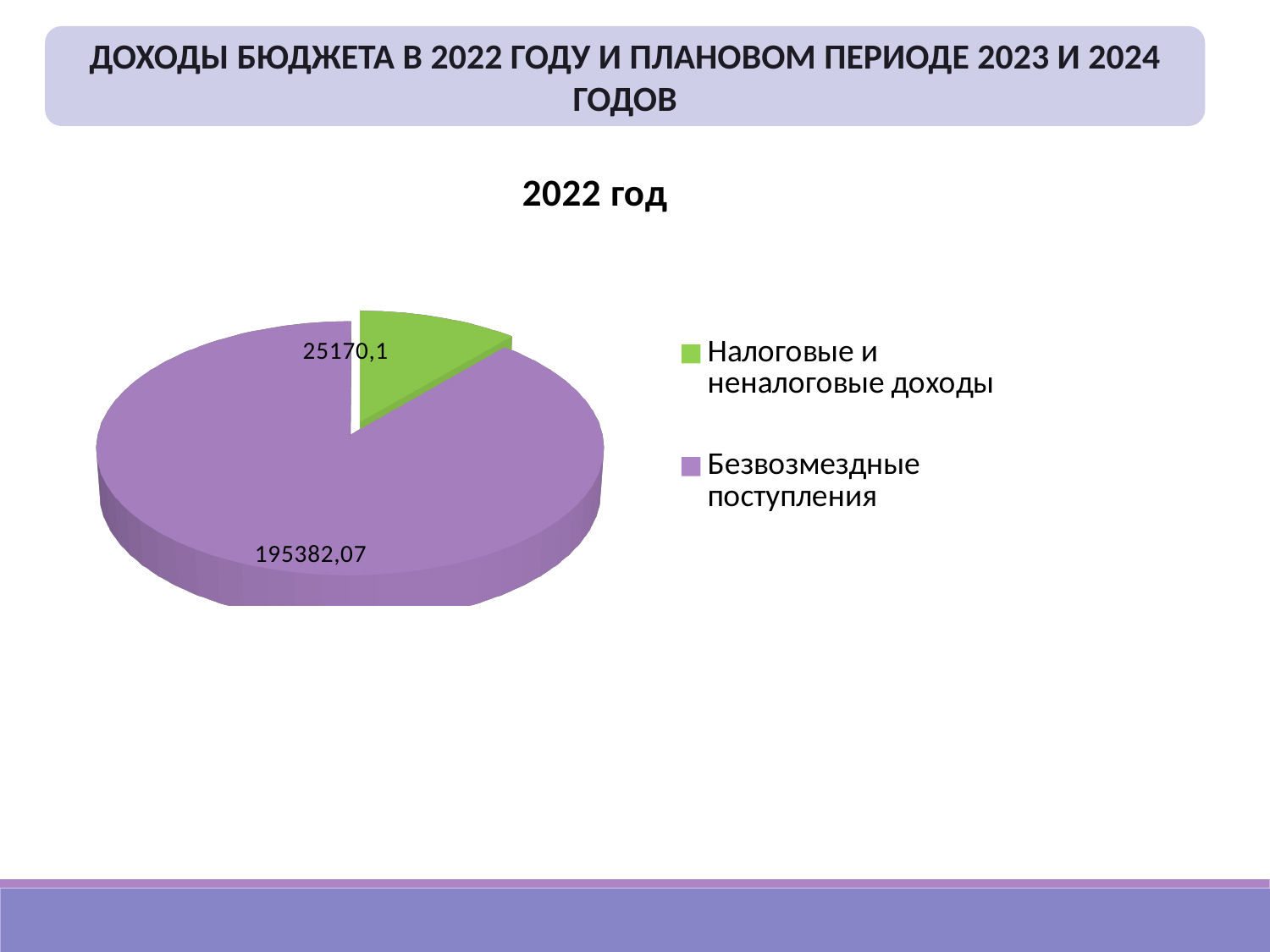
What is the title of the chart? 2022 год What is the value for Безвозмездные поступления? 195382,07 How many entries does the legend list? 2 Which category has the largest slice of the pie? Безвозмездные поступления What is the value for Налоговые и неналоговые доходы? 25170,1 Which is larger: Налоговые и неналоговые доходы or Безвозмездные поступления? Безвозмездные поступления What is the difference between Безвозмездные поступления and Налоговые и неналоговые доходы? 170211,97 How many slices does the pie chart have? 2 What colour is the slice for Налоговые и неналоговые доходы? Green Which category has the smallest slice of the pie? Налоговые и неналоговые доходы What is the total of the two slices in the pie? 220552,17 What type of chart is shown on the slide? Pie chart